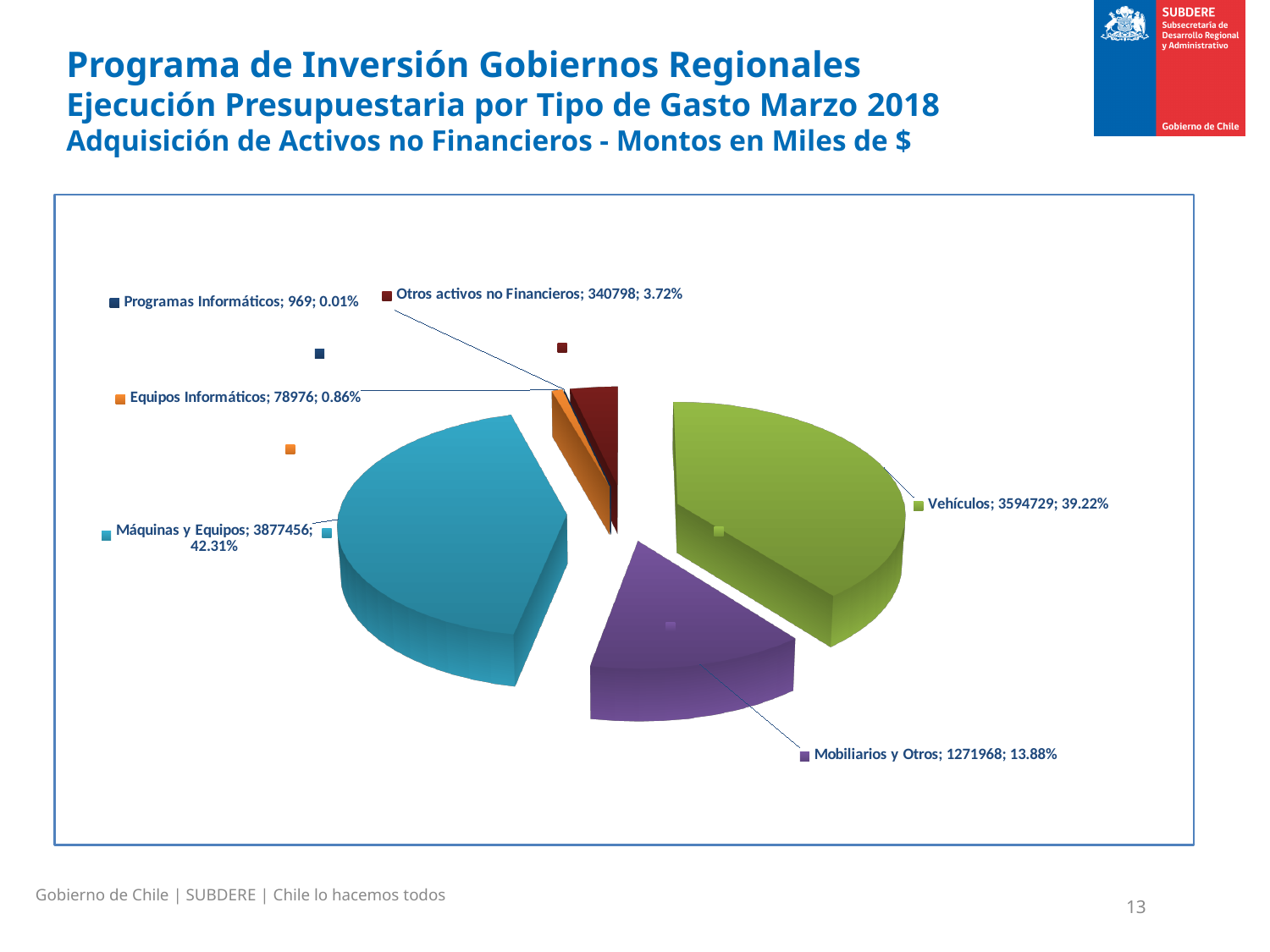
What is the value shown for Programas Informáticos? 969 What percentage share does Otros activos no Financieros have? 3.72% What is the value shown for Vehículos? 3594729 Which category has the smallest slice of the pie? Programas Informáticos What is the value shown for Mobiliarios y Otros? 1271968 What kind of chart is shown on the slide? Pie chart How many slices does the pie chart have? 6 What is the difference between the values for Máquinas y Equipos and Vehículos? 282727 Which category has the largest slice of the pie? Máquinas y Equipos What percentage share does Máquinas y Equipos have? 42.31% What unit are the amounts in the chart expressed in, according to the slide title? Miles de $ Which is larger, the value for Equipos Informáticos or the value for Otros activos no Financieros? Otros activos no Financieros